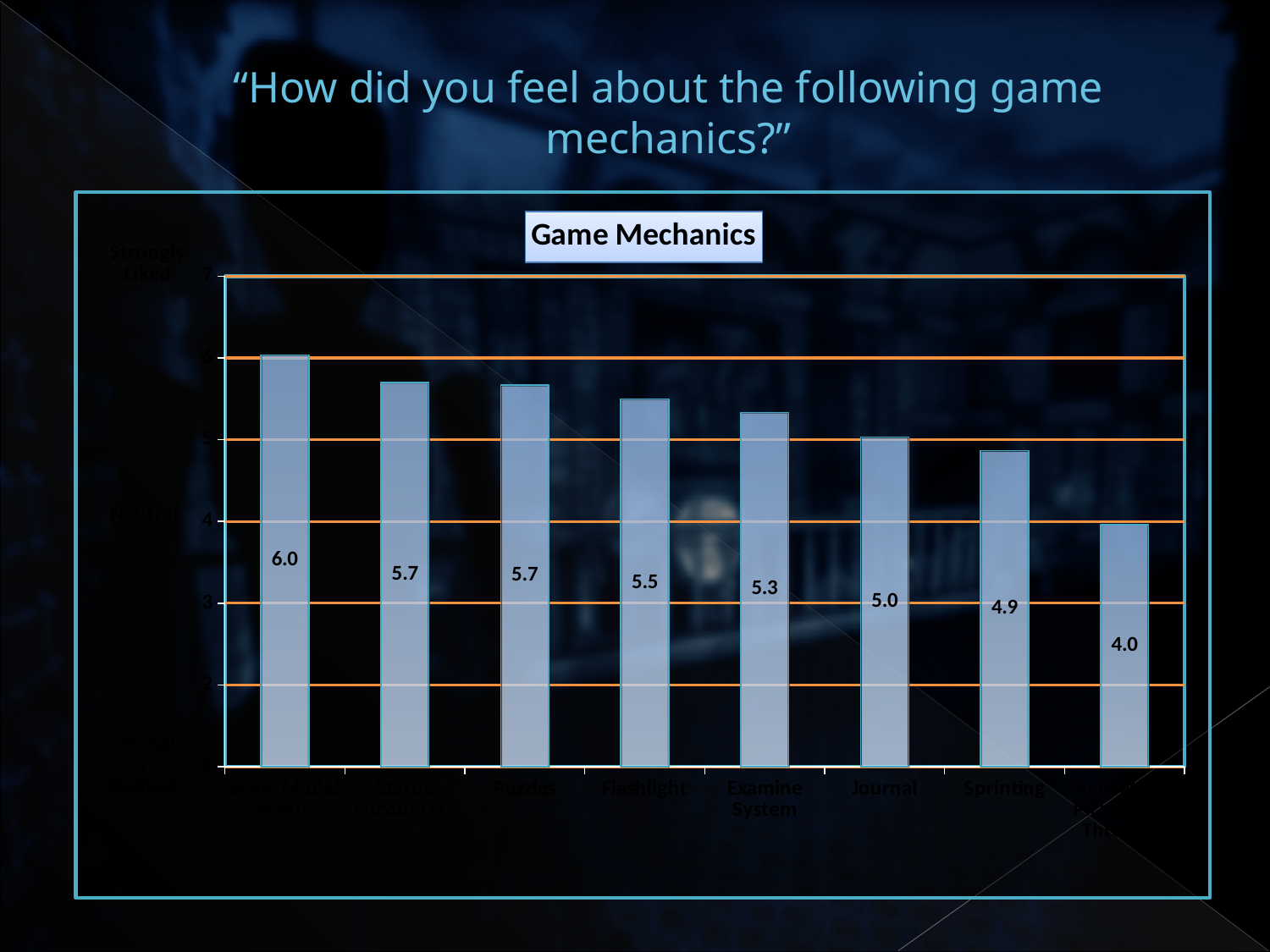
What is the value for Puzzles in the Game Mechanics chart? 5.7 What is the value for Flashlight in the Game Mechanics chart? 5.5 What is the difference between the values for Puzzles and Journal? 0.7 Which has a higher value, Flashlight or Sprinting? Flashlight What is the highest value shown on any bar in the Game Mechanics chart? 6.0 What is the lowest value shown on any bar in the Game Mechanics chart? 4.0 What is the value for Sprinting in the Game Mechanics chart? 4.9 Do the values rise or fall from left to right across the Game Mechanics chart? Fall What is the value for Examine System in the Game Mechanics chart? 5.3 How many bars are shown in the Game Mechanics chart? 8 What kind of chart is shown on the slide? Bar chart What is the value for Journal in the Game Mechanics chart? 5.0